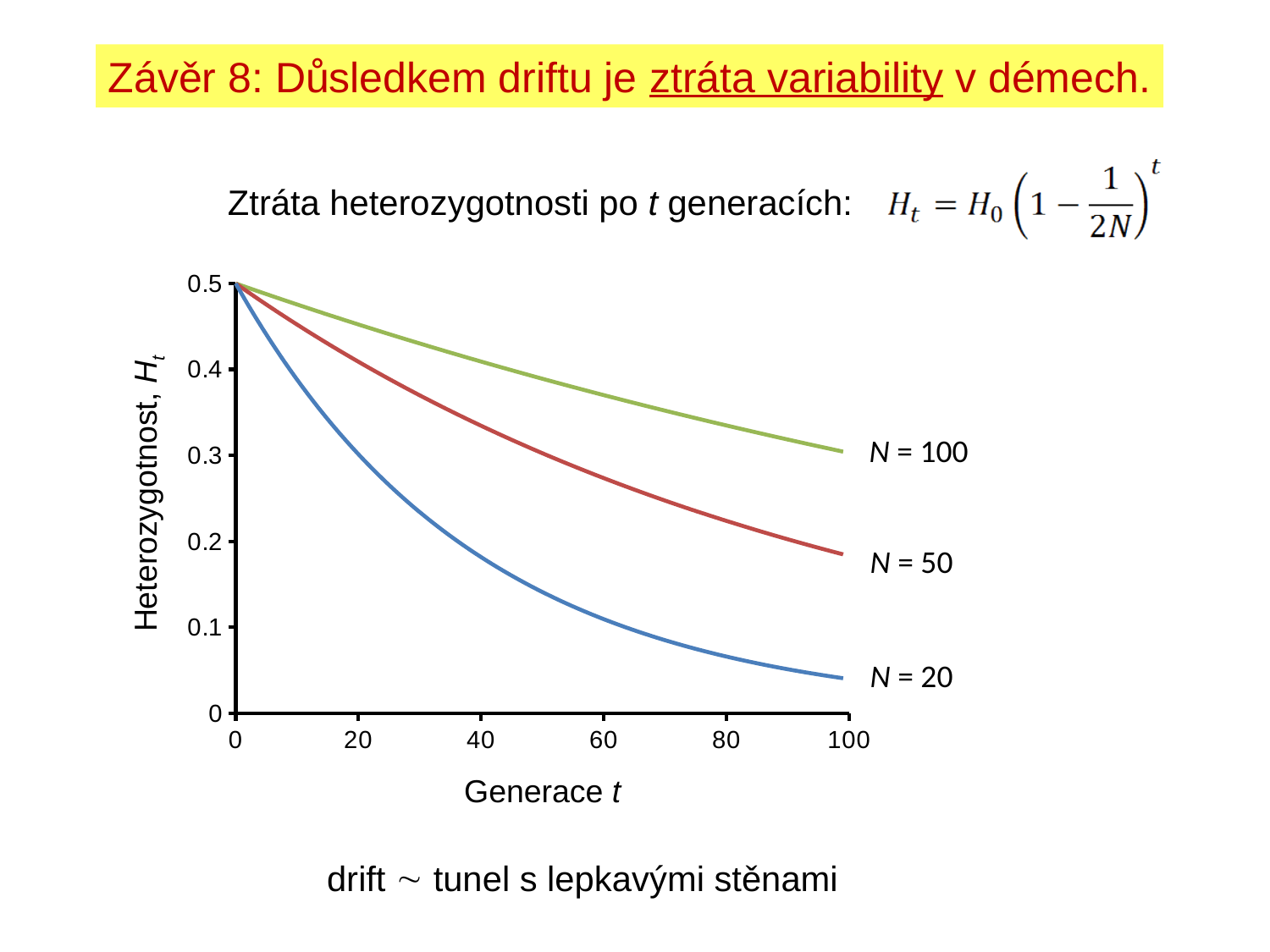
Which curve has the highest heterozygosity at generation 100? N = 100 Is the value for N = 100 at generation 100 greater or less than 0.4? less What is the label of the x axis? Generace t Is the value for N = 20 at generation 100 greater or less than 0.1? less How many curves (series) are plotted on the chart? 3 What colour is the curve for N = 20? blue Do the curves rise or fall as generation t increases? fall What kind of chart is shown on the slide? line chart What is the heterozygosity value of all three curves at generation 0? 0.5 At generation 60, which curve is higher: N = 100 or N = 20? N = 100 Is the value for N = 50 at generation 100 greater or less than 0.2? less Which curve has the lowest heterozygosity at generation 100? N = 20